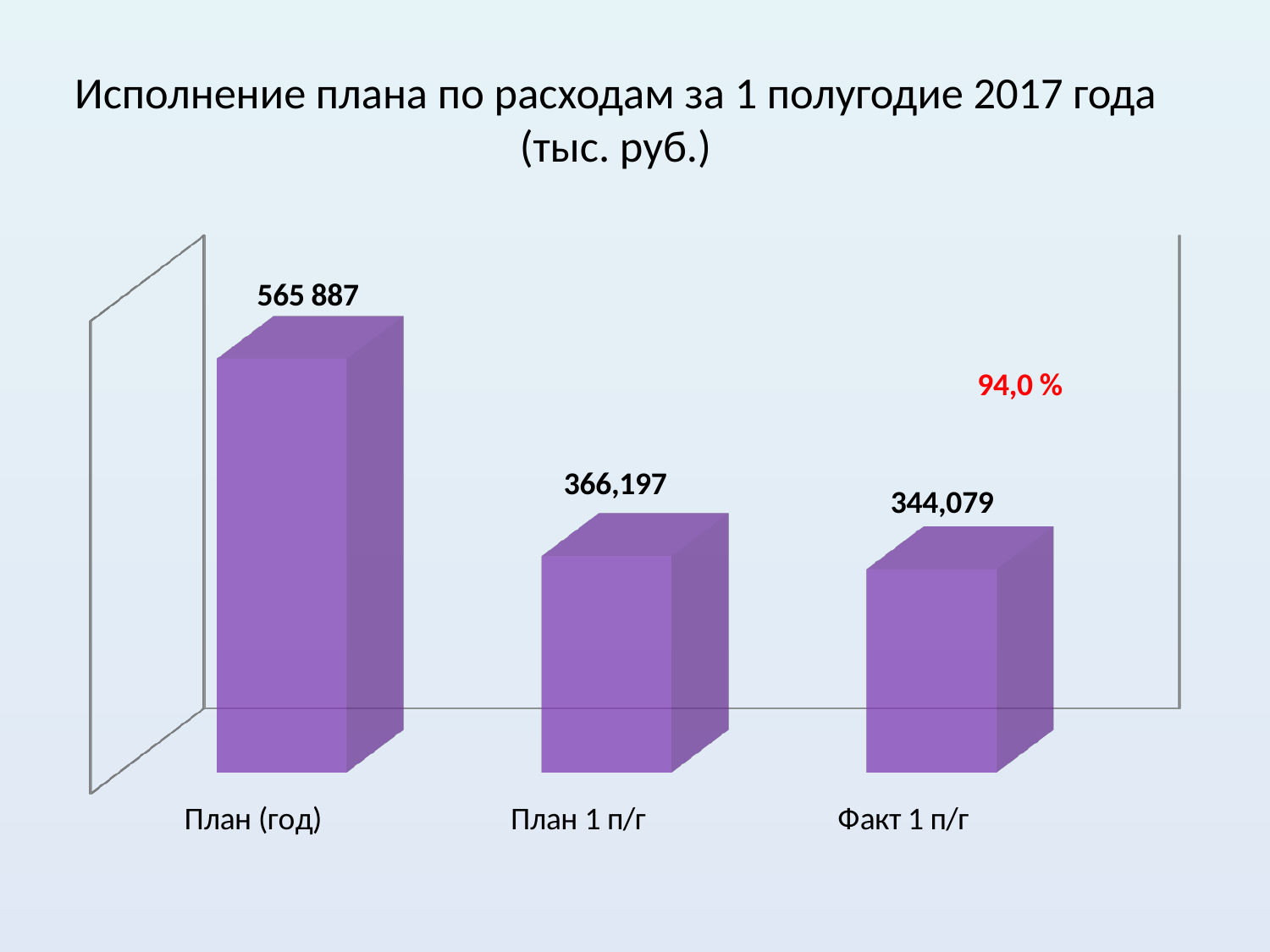
Do the values rise or fall from left to right across the categories? Fall What percentage is shown in red on the chart? 94,0 % Which category has the lowest value? Факт 1 п/г Which category has the highest value? План (год) What is the value for План 1 п/г? 366,197 What kind of chart is shown on the slide? Bar chart Which is larger, the value for План (год) or the value for План 1 п/г? План (год) What is the value for План (год)? 565 887 What is the difference between the values for План 1 п/г and Факт 1 п/г? 22,118 How many categories are shown in the chart? 3 What is the value for Факт 1 п/г? 344,079 What is the title of the chart? Исполнение плана по расходам за 1 полугодие 2017 года (тыс. руб.)